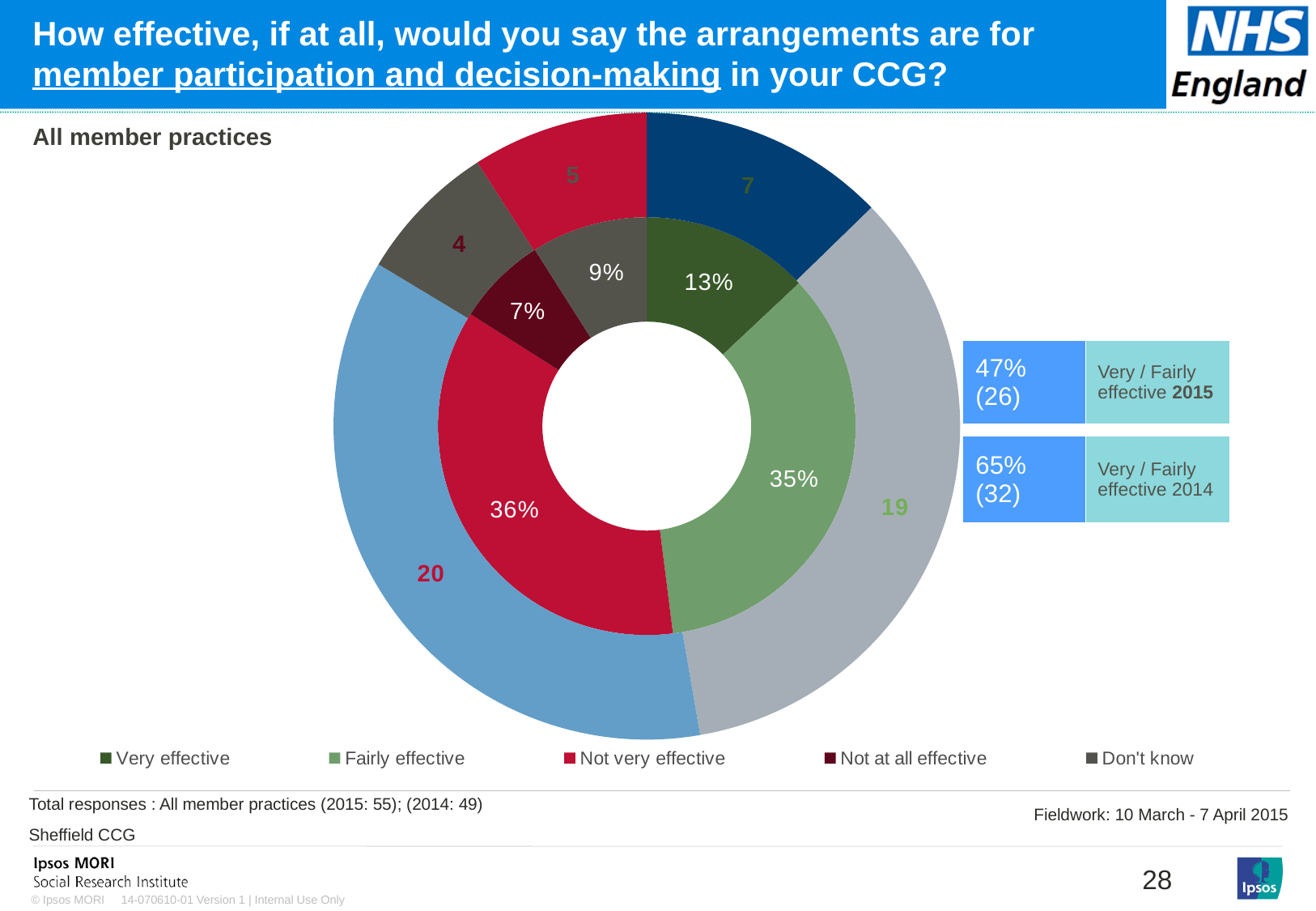
What percentage of member practices said the arrangements are 'Very effective' in the inner ring? 13% What kind of chart is shown on the slide? Doughnut chart What percentage is shown for 'Don't know' in the inner ring? 9% What is the combined 'Very / Fairly effective' figure for 2015 shown in the box beside the chart? 47% (26) Which response category has the smallest share in the inner ring? Not at all effective What is the difference between the 'Fairly effective' and 'Very effective' percentages in the inner ring? 22 percentage points What percentage is shown for 'Not very effective' in the inner ring? 36% How many response categories does the legend list? 5 Which response category has the largest share in the inner ring? Not very effective What percentage is shown for 'Not at all effective' in the inner ring? 7% What is the combined 'Very / Fairly effective' figure for 2014 shown in the box beside the chart? 65% (32) What percentage is shown for 'Fairly effective' in the inner ring? 35%